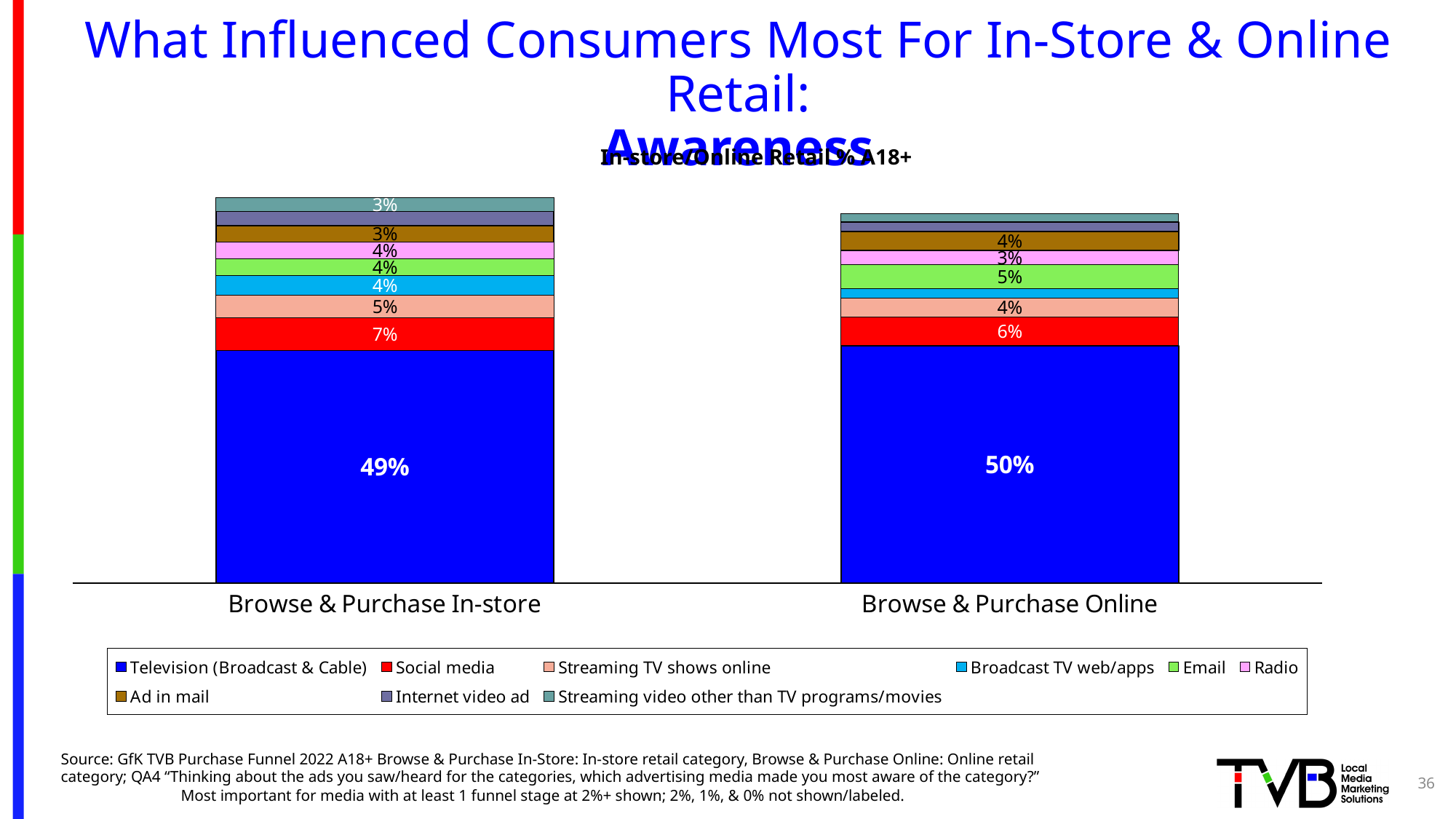
How many categories (bars) are shown on the x axis? 2 What percentage does Television (Broadcast & Cable) account for in the Browse & Purchase Online bar? 50% What percentage does Television (Broadcast & Cable) account for in the Browse & Purchase In-store bar? 49% Which media series is the largest segment in the Browse & Purchase In-store bar? Television (Broadcast & Cable) What is the Streaming TV shows online value for Browse & Purchase In-store? 5% Which category has the larger Television (Broadcast & Cable) value, Browse & Purchase In-store or Browse & Purchase Online? Browse & Purchase Online What is the Ad in mail value for Browse & Purchase Online? 4% What is the Email value for Browse & Purchase Online? 5% What is the difference between the Social media values for Browse & Purchase In-store and Browse & Purchase Online? 1% How many series does the legend list? 9 What is the Social media value for Browse & Purchase In-store? 7% What kind of chart is shown on the slide? Stacked bar chart